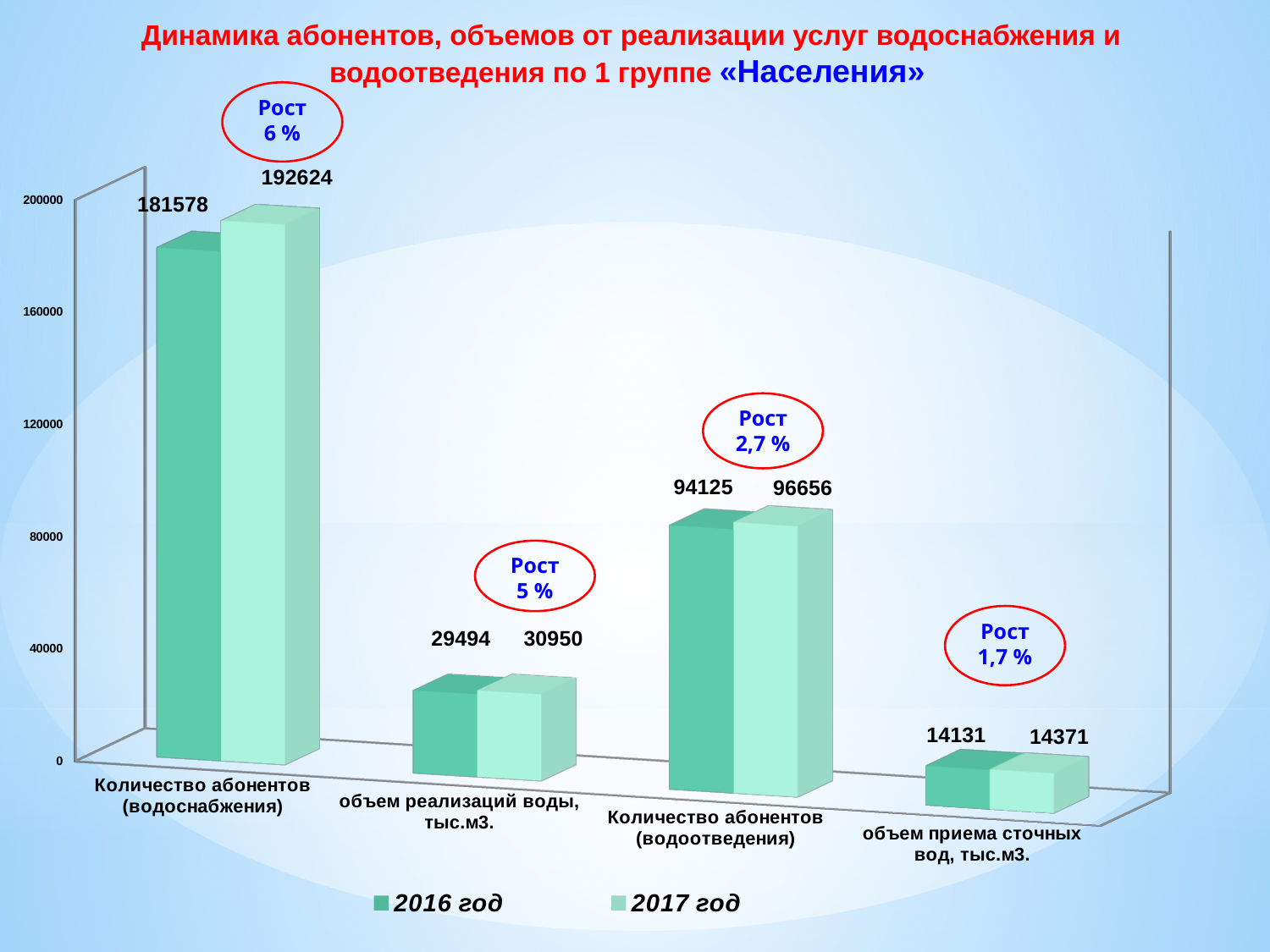
What growth percentage (Рост) is shown above the Количество абонентов (водоотведения) bars? 2,7 % Which is larger for объем реализаций воды, тыс.м3.: the 2016 год value or the 2017 год value? 2017 год What kind of chart is shown on the slide? Bar chart Which category has the highest value for 2016 год? Количество абонентов (водоснабжения) What is the value for 2017 год for Количество абонентов (водоснабжения)? 192624 How many series does the legend list? 2 What is the value for 2017 год for Количество абонентов (водоотведения)? 96656 What is the difference between the 2017 год and 2016 год values for Количество абонентов (водоснабжения)? 11046 Which category has the lowest value for 2017 год? объем приема сточных вод, тыс.м3. What is the value for 2016 год for объем реализаций воды, тыс.м3.? 29494 What is the value for 2016 год for объем приема сточных вод, тыс.м3.? 14131 How many categories are shown on the x axis? 4